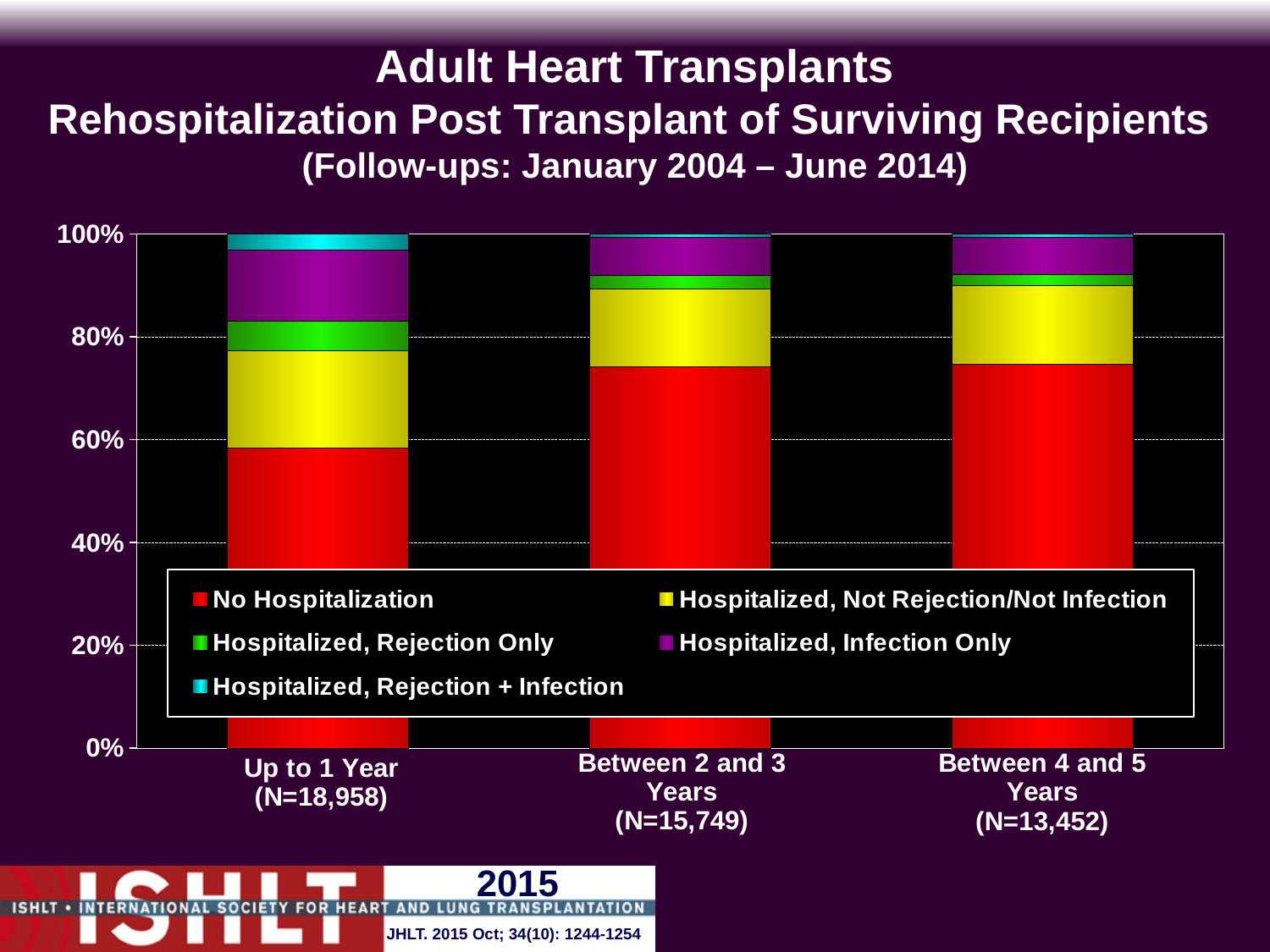
Is the No Hospitalization share for Between 4 and 5 Years greater or less than 80%? less What is the N shown for the Up to 1 Year category? N=18,958 Which follow-up category has the largest Hospitalized, Infection Only share? Up to 1 Year Which is larger: the No Hospitalization share for Up to 1 Year or for Between 2 and 3 Years? Between 2 and 3 Years Is the No Hospitalization share for Between 2 and 3 Years greater or less than 60%? greater What kind of chart is shown on the slide? Stacked bar chart How many follow-up categories are shown on the x axis? 3 How many series does the legend list? 5 Which follow-up category has the smallest No Hospitalization share? Up to 1 Year Which colour represents No Hospitalization in the legend? Red Does the No Hospitalization share rise or fall from Up to 1 Year to Between 2 and 3 Years? rise Is the No Hospitalization share for Up to 1 Year greater or less than 40%? greater